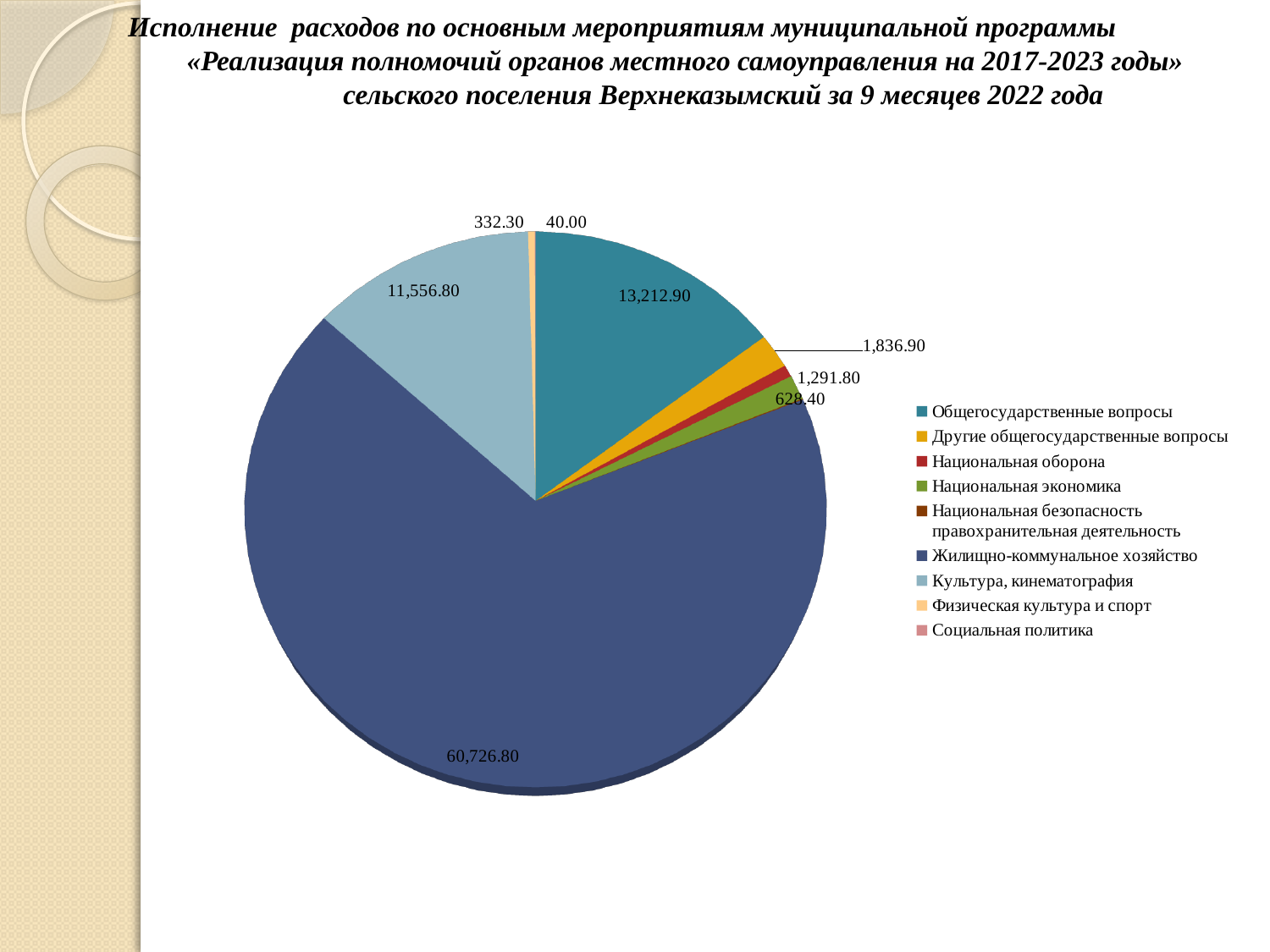
What is the difference between Жилищно-коммунальное хозяйство and Общегосударственные вопросы? 47,513.90 What is the value for Жилищно-коммунальное хозяйство? 60,726.80 What is the value for Культура, кинематография? 11,556.80 How many categories does the legend of the pie chart list? 9 Which colour represents Жилищно-коммунальное хозяйство in the legend? dark blue What kind of chart is shown on the slide? pie chart Which category has the largest slice of the pie? Жилищно-коммунальное хозяйство What is the value for Общегосударственные вопросы? 13,212.90 Which is larger, Общегосударственные вопросы or Культура, кинематография? Общегосударственные вопросы What is the value for Национальная оборона? 628.40 What is the value for Национальная экономика? 1,291.80 What is the difference between Другие общегосударственные вопросы and Национальная оборона? 1,208.50